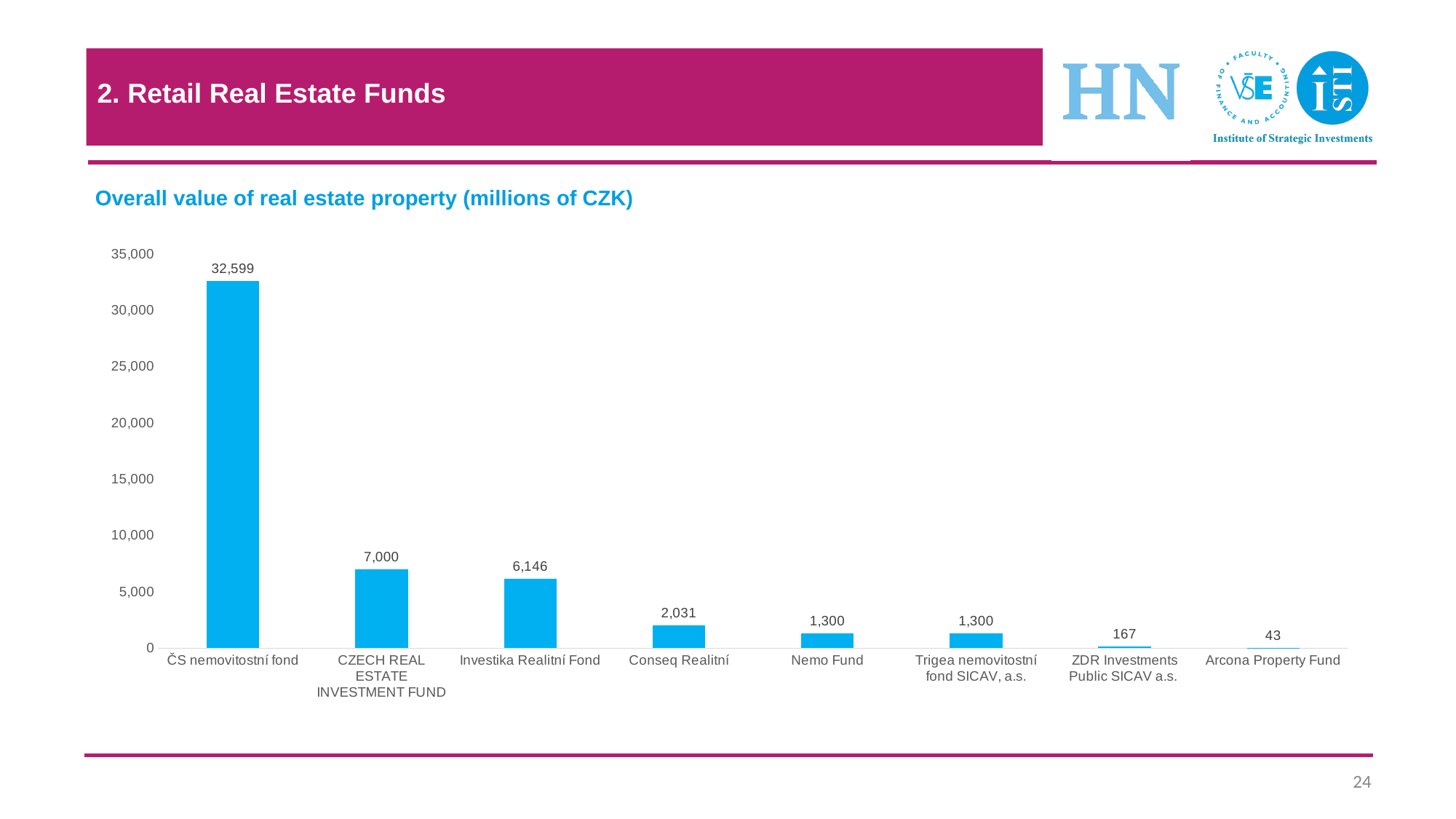
What kind of chart is shown on the slide? Bar chart What is the overall value of real estate property for ČS nemovitostní fond? 32,599 What is the value shown for Arcona Property Fund? 43 Which fund has the lowest overall value of real estate property? Arcona Property Fund Is the value for ČS nemovitostní fond greater or less than 30,000? greater Which fund has the highest overall value of real estate property? ČS nemovitostní fond Which is larger, the value for Conseq Realitní or the value for Nemo Fund? Conseq Realitní What is the value shown for Conseq Realitní? 2,031 What is the value shown for Investika Realitní Fond? 6,146 What is the difference between the values for CZECH REAL ESTATE INVESTMENT FUND and Investika Realitní Fond? 854 How many funds are shown in the chart? 8 What is the title of the chart? Overall value of real estate property (millions of CZK)